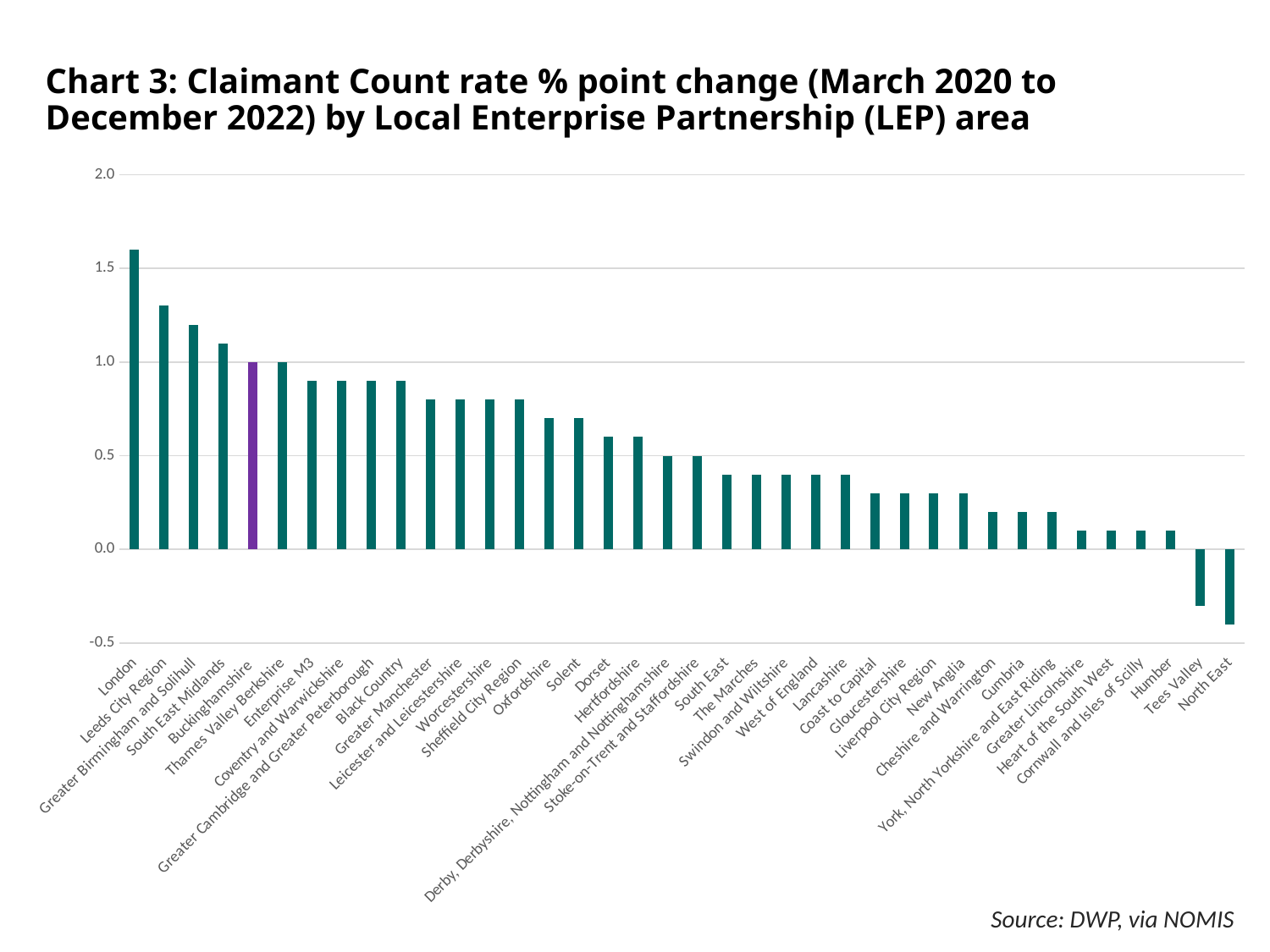
Do the values rise or fall moving from left to right along the x axis? Fall Which LEP area has the highest Claimant Count rate % point change? London Is the value for London greater or less than 1.5? greater Is the value for Cumbria greater or less than 0.5? less Which LEP area's bar is coloured purple rather than green? Buckinghamshire Which has the larger value, London or Leeds City Region? London Is the value for Leeds City Region greater or less than 1.0? greater What type of chart is shown on the slide? Bar chart Which LEP area has the lowest Claimant Count rate % point change? North East Which has the larger value, Humber or Tees Valley? Humber How many LEP areas are shown in the chart? 38